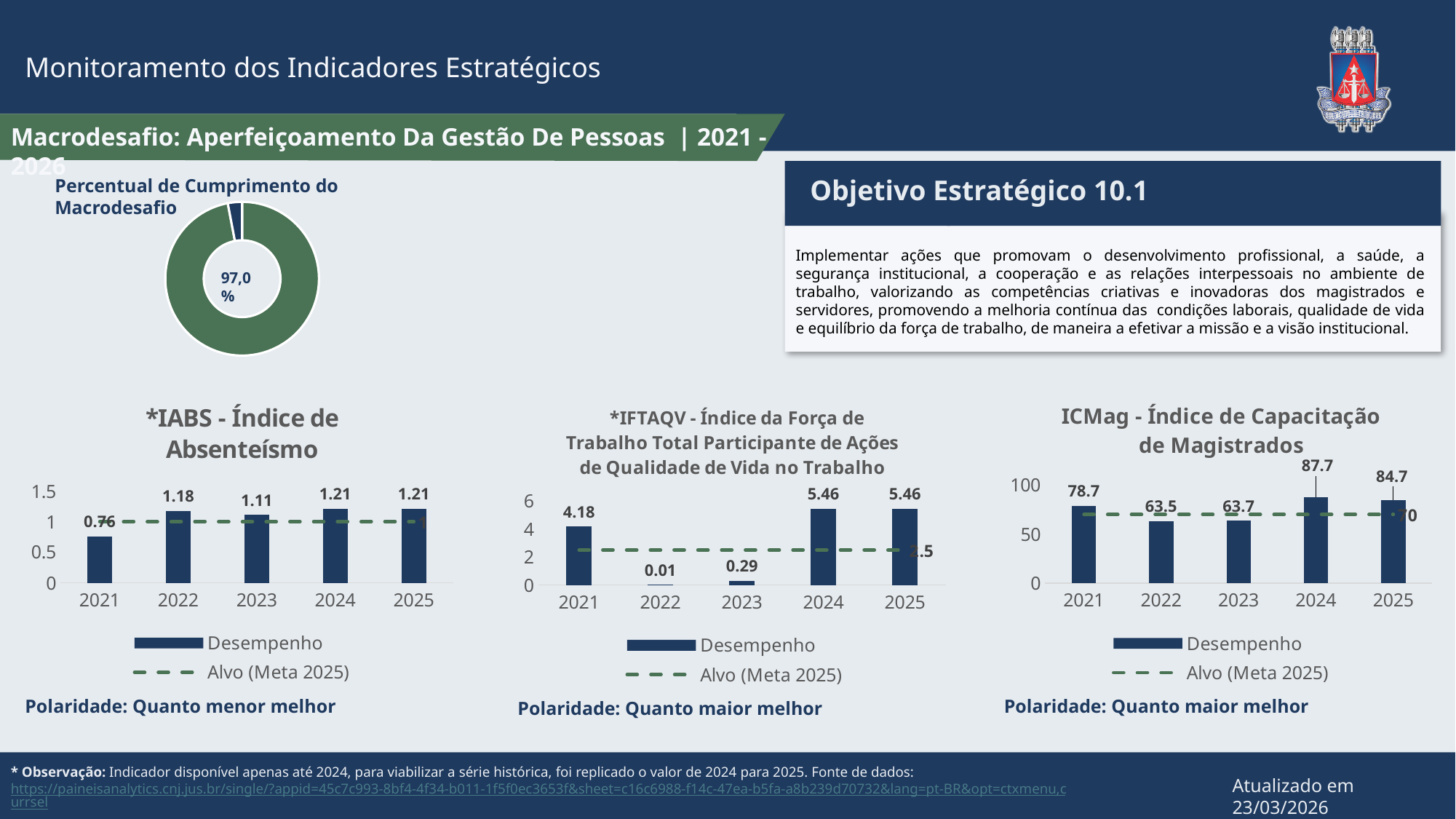
In the IABS - Índice de Absenteísmo chart, what is the Desempenho value for 2021? 0.76 In the IFTAQV chart, what is the Desempenho value for 2023? 0.29 In the ICMag - Índice de Capacitação de Magistrados chart, what is the Desempenho value for 2024? 87.7 In the IABS - Índice de Absenteísmo chart, which year has the lowest Desempenho value? 2021 What percentage is shown in the centre of the Percentual de Cumprimento do Macrodesafio donut chart? 97,0% In the ICMag - Índice de Capacitação de Magistrados chart, what is the difference between the 2024 and 2025 values? 3.0 In the IABS - Índice de Absenteísmo chart, what is the difference between the 2022 and 2023 values? 0.07 How many series does the legend of the ICMag - Índice de Capacitação de Magistrados chart list? 2 In the IFTAQV chart, what is the Alvo (Meta 2025) value shown on the dashed line? 2.5 In the IFTAQV chart, which year has the lowest Desempenho value? 2022 In the IFTAQV chart, is the 2021 value larger or smaller than the 2024 value? smaller In the ICMag - Índice de Capacitação de Magistrados chart, which year has the highest Desempenho value? 2024